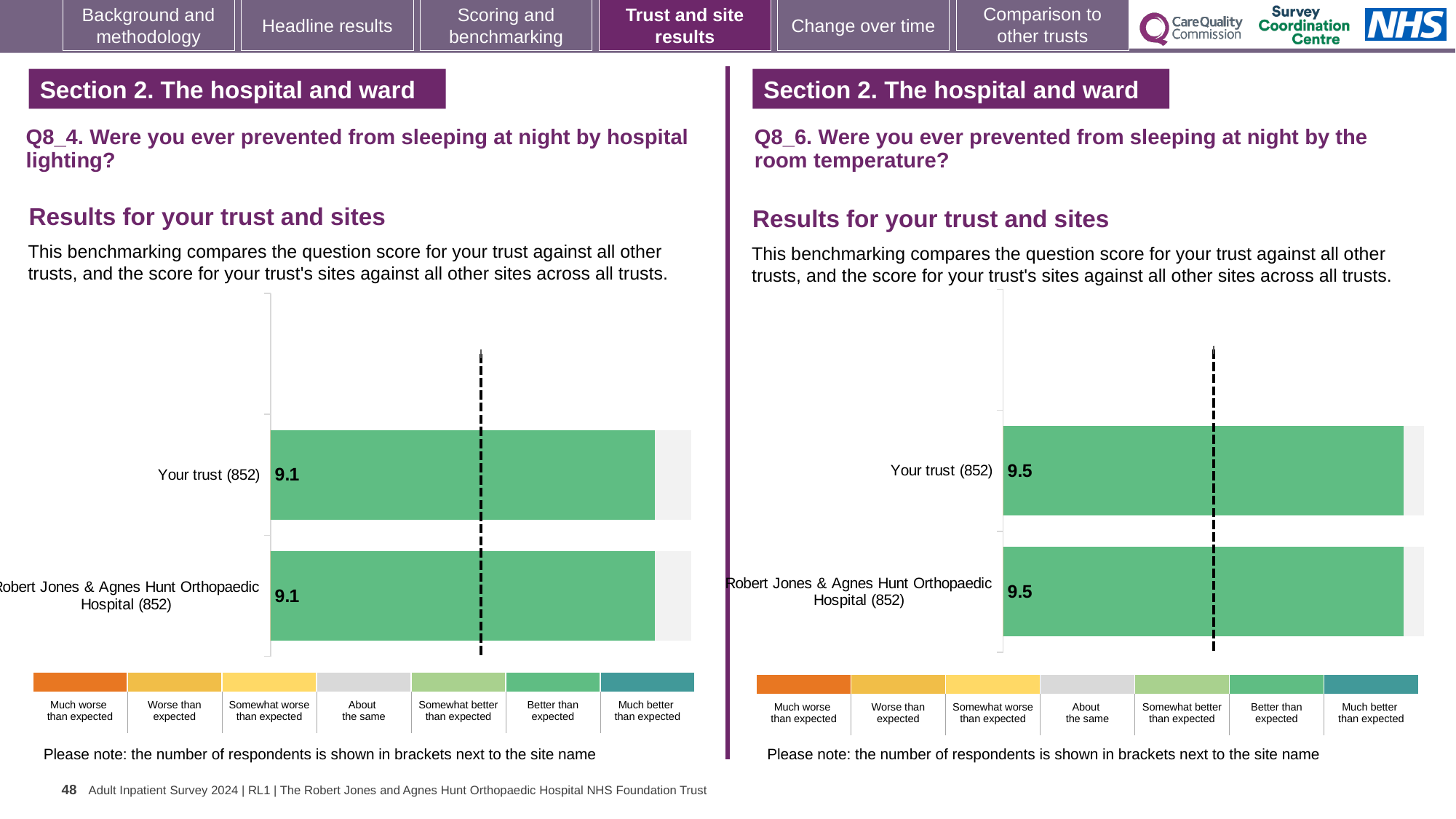
On the Q8_4 chart (hospital lighting), what is the score for Robert Jones & Agnes Hunt Orthopaedic Hospital (852)? 9.1 On the Q8_6 chart (room temperature), how many respondents are shown in brackets next to Your trust? 852 According to the colour key below the Q8_4 chart (hospital lighting), which benchmark category does the green colour of the bars represent? Better than expected On the Q8_4 chart (hospital lighting), what is the score for Your trust (852)? 9.1 On the Q8_6 chart (room temperature), what is the difference between the score for Your trust and the score for Robert Jones & Agnes Hunt Orthopaedic Hospital? 0 What kind of chart is used on the Q8_4 chart (hospital lighting)? Bar chart On the Q8_6 chart (room temperature), what is the score for Your trust (852)? 9.5 How many bars are plotted on the Q8_6 chart (room temperature)? 2 On the Q8_4 chart (hospital lighting), what is the difference between the score for Your trust and the score for Robert Jones & Agnes Hunt Orthopaedic Hospital? 0 What kind of chart is used on the Q8_6 chart (room temperature)? Bar chart How many bars are plotted on the Q8_4 chart (hospital lighting)? 2 On the Q8_6 chart (room temperature), what is the score for Robert Jones & Agnes Hunt Orthopaedic Hospital (852)? 9.5